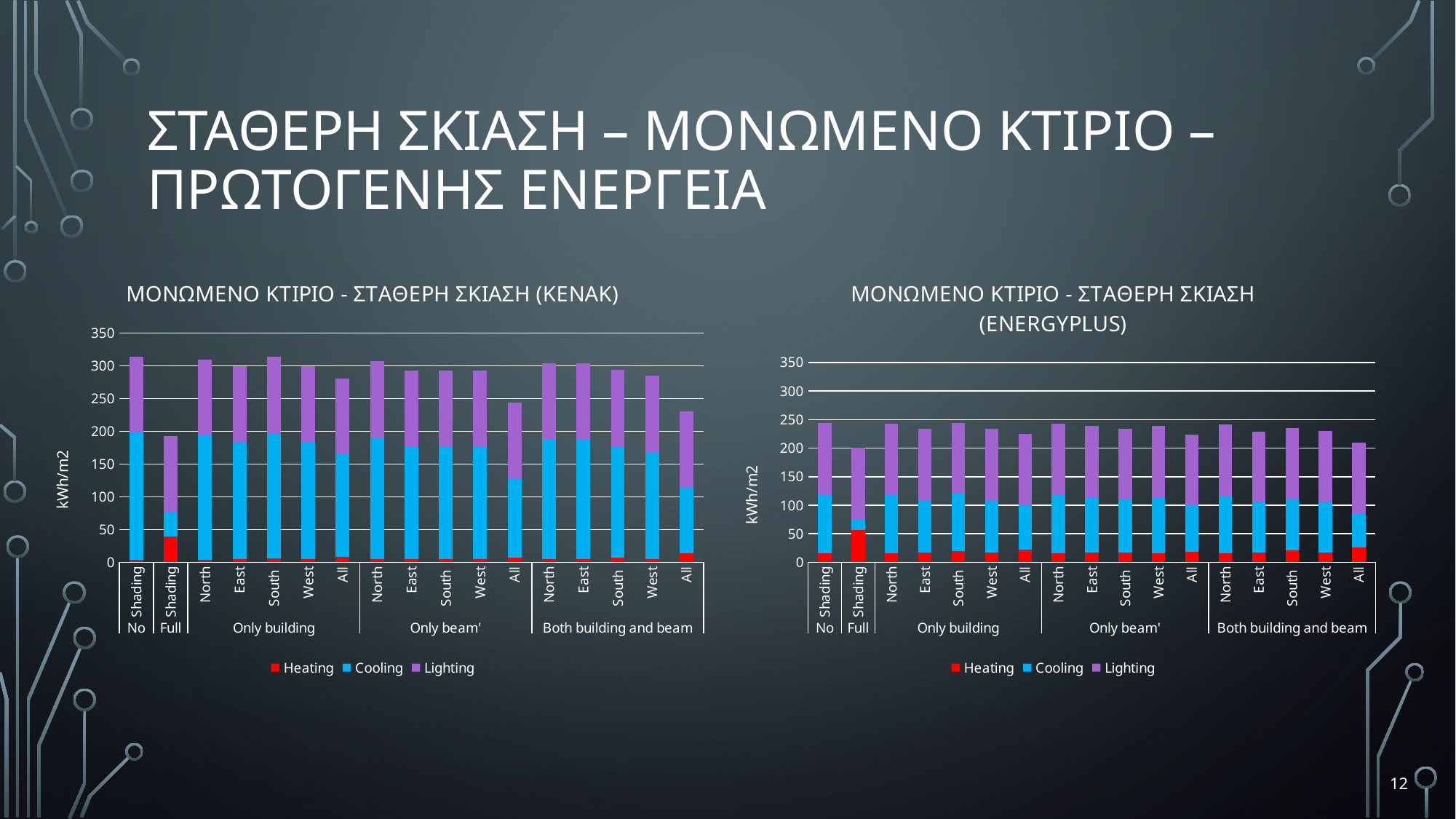
In the left chart (KENAK), how many bars are plotted in total? 17 In the left chart (KENAK), is the total for 'All' under 'Both building and beam' greater or less than 250? less In the left chart (KENAK), is the total for No Shading greater or less than 300? greater In the right chart (ENERGYPLUS), is the total for Full Shading greater or less than 250? less In the right chart (ENERGYPLUS), how many bars are in the 'Only building' group? 5 How many series does the legend of the right chart (ENERGYPLUS) list? 3 In the left chart (KENAK), which has the larger Heating value: No Shading or Full Shading? Full Shading What kind of chart is the left chart titled 'ΜΟΝΩΜΕΝΟ ΚΤΙΡΙΟ - ΣΤΑΘΕΡΗ ΣΚΙΑΣΗ (KENAK)'? Stacked bar chart In the right chart (ENERGYPLUS), which has the larger total: No Shading or 'All' under 'Both building and beam'? No Shading In the left chart (KENAK), which bar has the lowest total? Full Shading What is the y-axis label of the left chart (KENAK)? kWh/m2